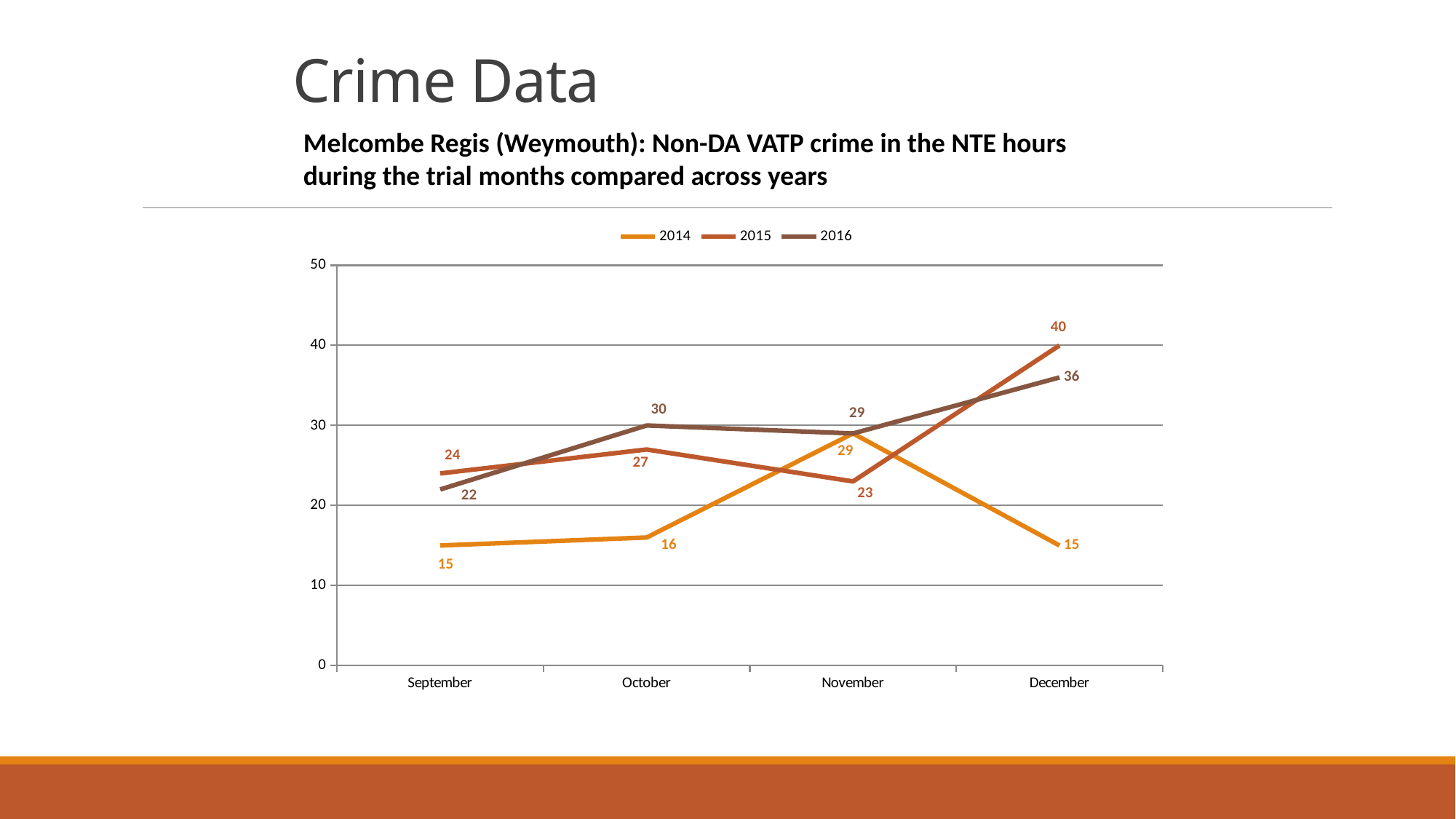
What is the value for 2014 in October? 16 In which month does the 2015 series reach its highest value? December Which series has the lowest value in September? 2014 Which is larger in October, the value for 2015 or the value for 2016? 2016 What is the value for 2016 in September? 22 What is the value for 2015 in December? 40 Does the 2014 series rise or fall from November to December? fall What type of chart is shown on the slide? line chart How many months are plotted along the x axis? 4 How many series does the legend list? 3 In which month is the 2014 series at its highest? November What is the difference between the 2015 and 2016 values in December? 4